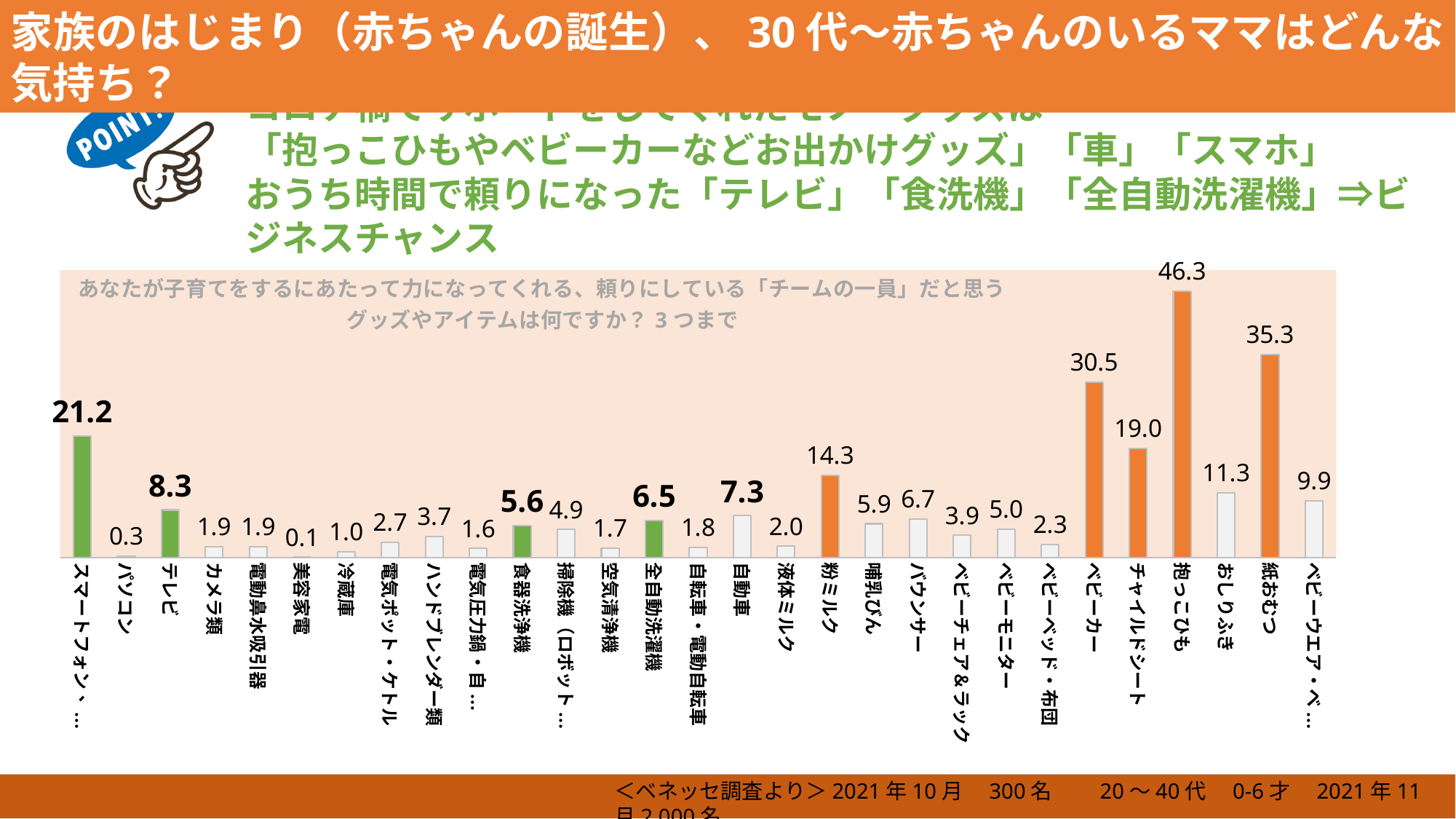
What is the difference between the values for ベビーカー and チャイルドシート? 11.5 How many categories are shown in the chart? 29 What is the value for 全自動洗濯機? 6.5 What is the value for テレビ? 8.3 What is the difference between the values for 抱っこひも and 紙おむつ? 11.0 Which category has the highest value? 抱っこひも Which is larger, the value for 自動車 or the value for 食器洗浄機? 自動車 What is the value for 抱っこひも? 46.3 What is the value for 粉ミルク? 14.3 What kind of chart is shown on the slide? bar chart What colour is the bar for 紙おむつ? orange Which category has the lowest value? 美容家電